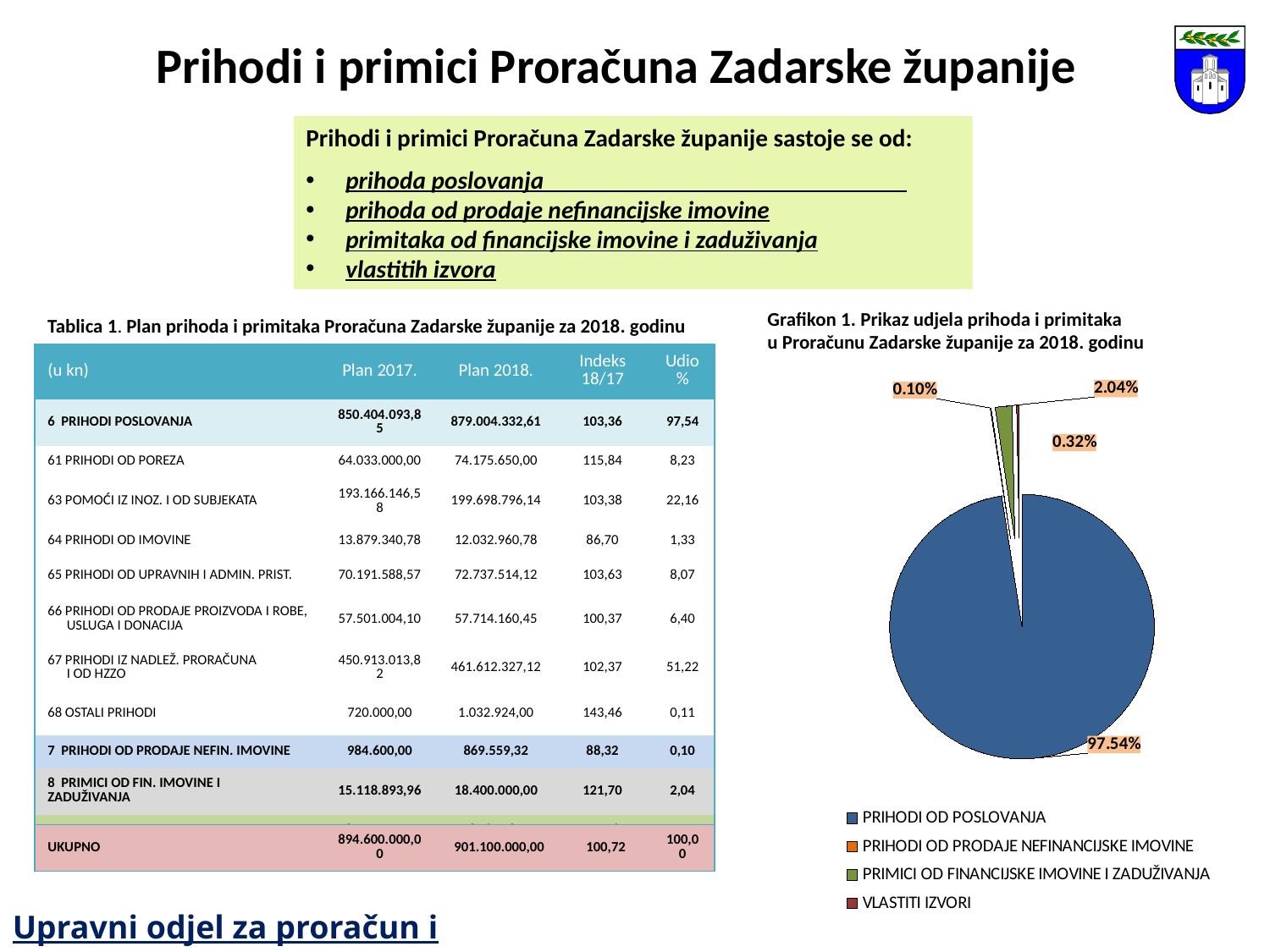
How many entries does the legend of the pie chart list? 4 How many slices does the pie chart have? 4 Which category has the smallest share in the pie chart? PRIHODI OD PRODAJE NEFINANCIJSKE IMOVINE What kind of chart is shown on the slide? pie chart What share of the pie does PRIMICI OD FINANCIJSKE IMOVINE I ZADUŽIVANJA have? 2.04% What share of the pie does VLASTITI IZVORI have? 0.32% What share of the pie does PRIHODI OD PRODAJE NEFINANCIJSKE IMOVINE have? 0.10% Which category has the largest share in the pie chart? PRIHODI OD POSLOVANJA Which has the larger share, VLASTITI IZVORI or PRIMICI OD FINANCIJSKE IMOVINE I ZADUŽIVANJA? PRIMICI OD FINANCIJSKE IMOVINE I ZADUŽIVANJA What is the difference in percentage points between the share of PRIHODI OD POSLOVANJA and the share of PRIMICI OD FINANCIJSKE IMOVINE I ZADUŽIVANJA? 95.50% What colour is the slice for PRIHODI OD POSLOVANJA in the pie chart? blue